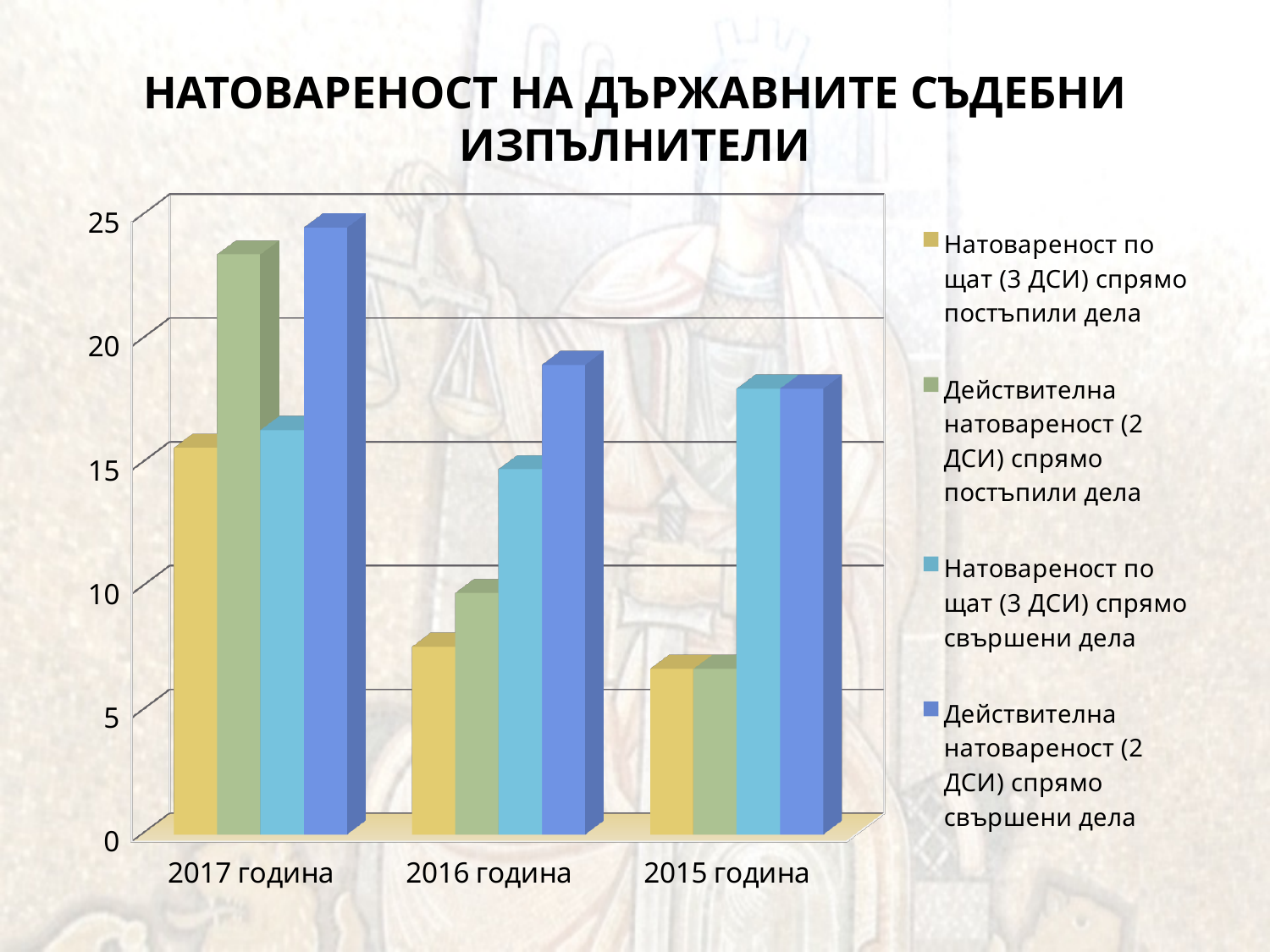
How many series does the legend list? 4 How many year categories are shown on the x axis? 3 Is the value for "Натовареност по щат (3 ДСИ) спрямо постъпили дела" in 2016 година greater or less than 10? less What is the title of the chart? НАТОВАРЕНОСТ НА ДЪРЖАВНИТЕ СЪДЕБНИ ИЗПЪЛНИТЕЛИ What kind of chart is shown on the slide? bar chart Does the value for "Натовареност по щат (3 ДСИ) спрямо постъпили дела" rise or fall moving from 2017 година to 2015 година along the x axis? fall In 2016 година, which series has the highest value? Действителна натовареност (2 ДСИ) спрямо свършени дела Is the value for "Действителна натовареност (2 ДСИ) спрямо свършени дела" in 2015 година greater or less than 15? greater In 2016 година, which series has the lowest value? Натовареност по щат (3 ДСИ) спрямо постъпили дела Is the value for "Действителна натовареност (2 ДСИ) спрямо постъпили дела" in 2017 година greater or less than 20? greater For "Действителна натовареност (2 ДСИ) спрямо постъпили дела", which is larger: the value for 2017 година or for 2016 година? 2017 година